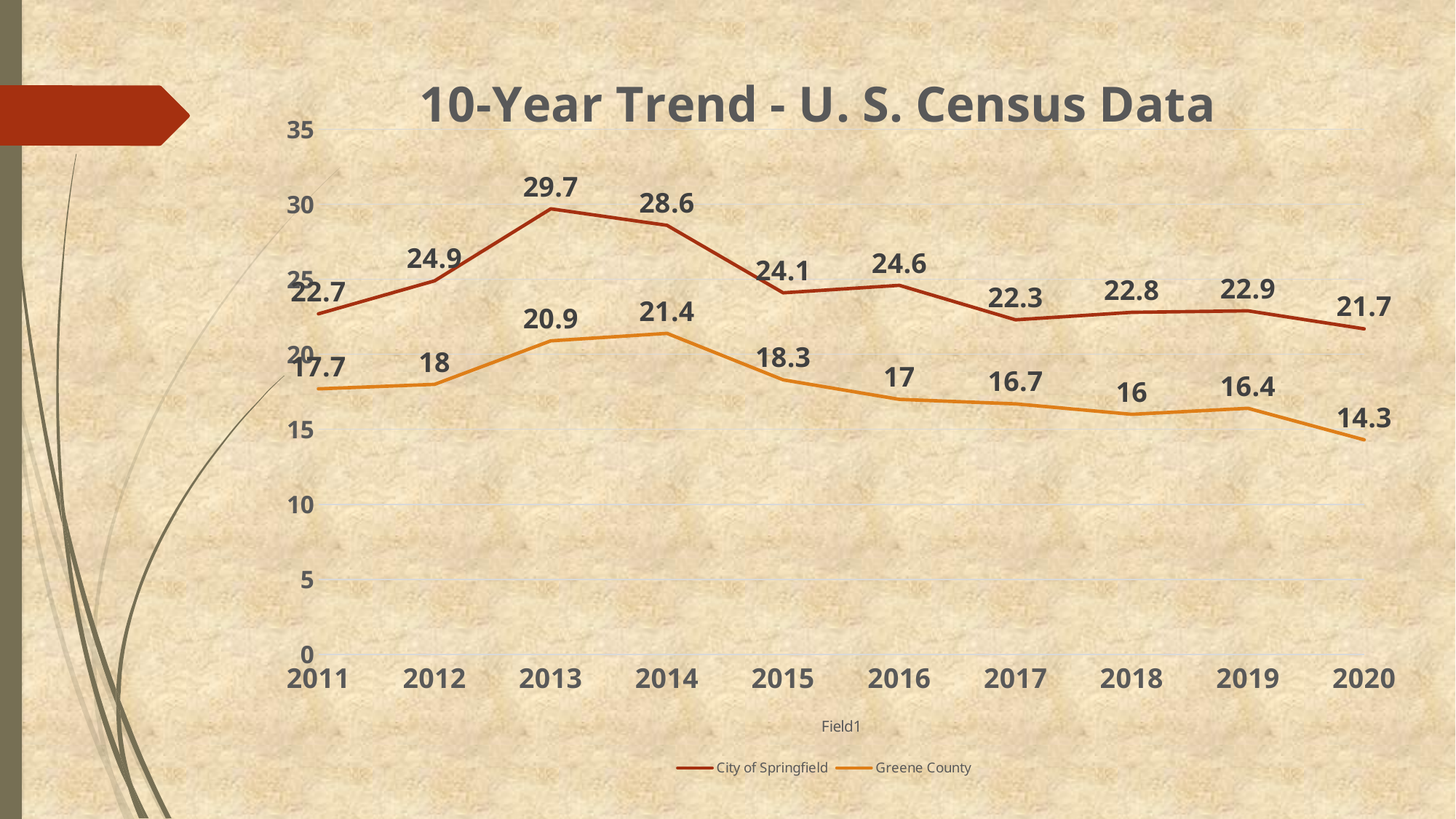
In which year is the City of Springfield value highest? 2013 What is the value for City of Springfield in 2013? 29.7 How many series does the legend list? 2 What is the title of the chart? 10-Year Trend - U. S. Census Data In which year is the Greene County value lowest? 2020 What is the value for Greene County in 2014? 21.4 Does the Greene County value rise or fall from 2014 to 2020? Fall How many years are shown on the x axis? 10 What kind of chart is this? Line chart What is the difference between City of Springfield and Greene County in 2016? 7.6 Which is larger in 2011: City of Springfield or Greene County? City of Springfield What is the value for Greene County in 2020? 14.3